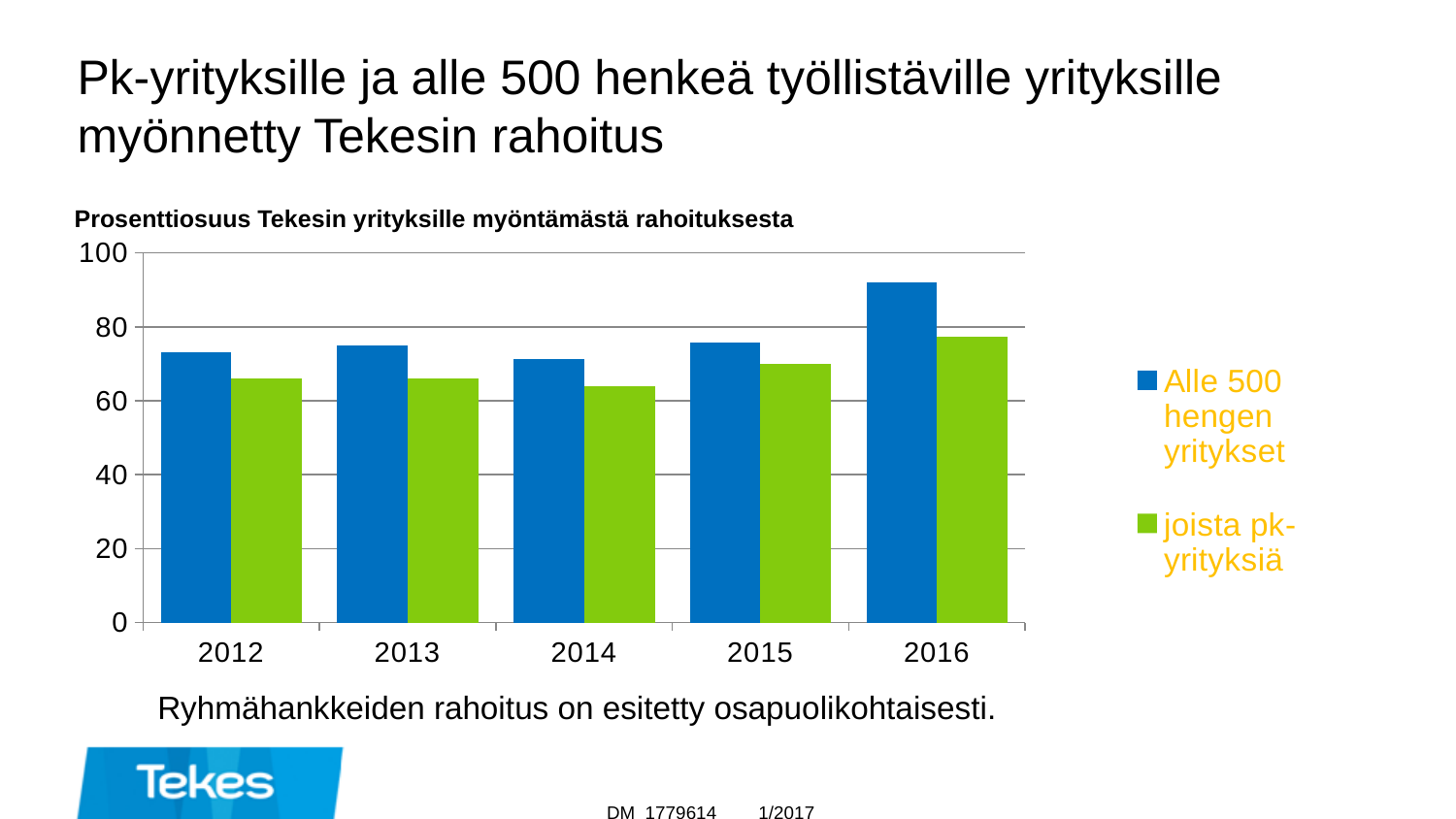
Is the value for 'Alle 500 hengen yritykset' in 2016 greater or less than 80? greater Is the value for 'joista pk-yrityksiä' in 2016 greater or less than 80? less Which is larger in 2016: the value for 'Alle 500 hengen yritykset' or the value for 'joista pk-yrityksiä'? Alle 500 hengen yritykset In which year is the value for 'Alle 500 hengen yritykset' highest? 2016 Does the value for 'Alle 500 hengen yritykset' rise or fall from 2015 to 2016? rise Is the value for 'joista pk-yrityksiä' in 2014 greater or less than 60? greater How many series does the chart legend list? 2 What colour are the bars for 'joista pk-yrityksiä'? green What kind of chart is shown on the slide? bar chart How many years are shown on the x axis of the chart? 5 In which year is the value for 'joista pk-yrityksiä' highest? 2016